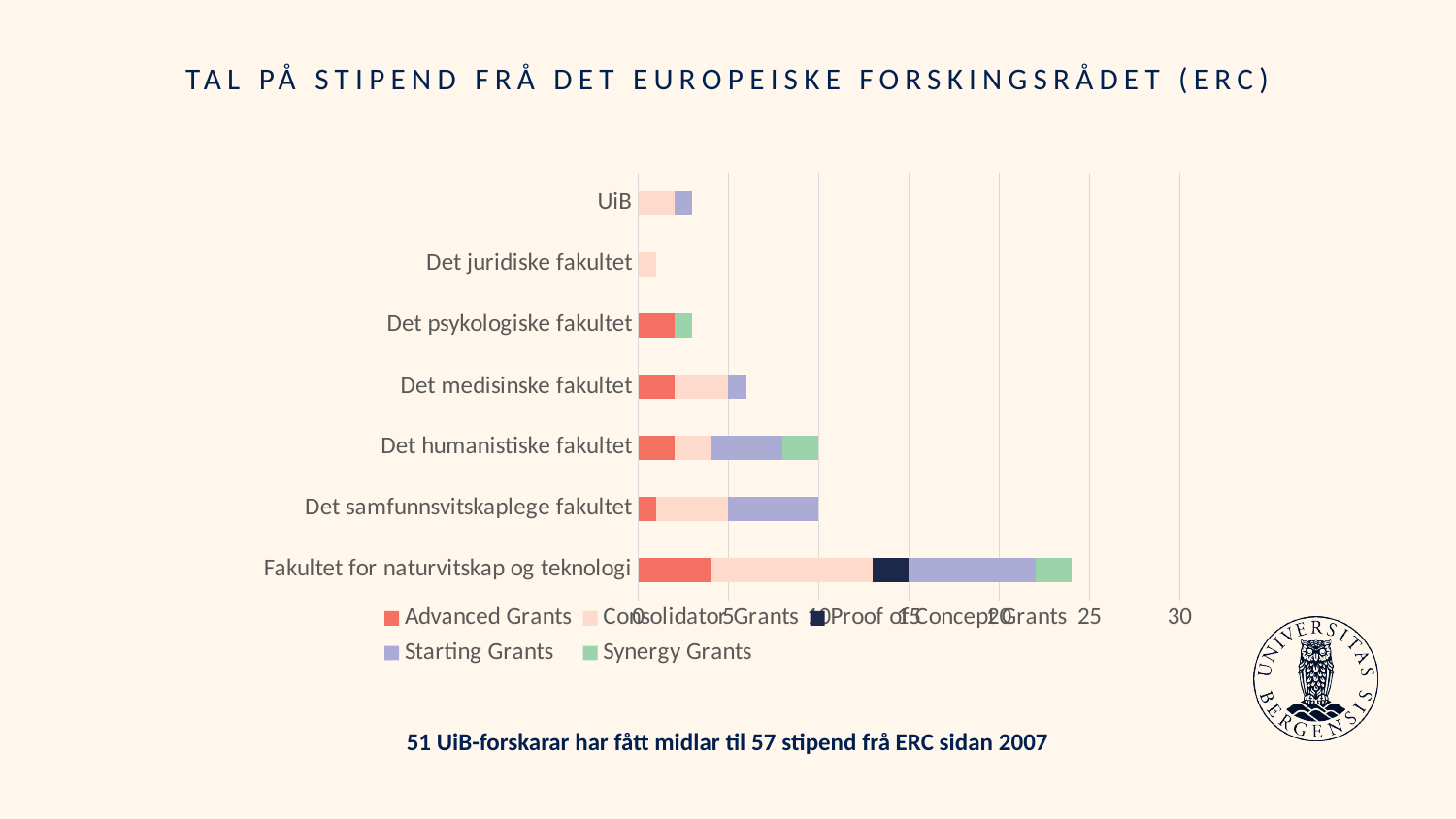
Is the total value for Det medisinske fakultet greater or less than 5? greater Is the total value for Fakultet for naturvitskap og teknologi greater or less than 20? greater Which has a larger total bar, Det medisinske fakultet or Det psykologiske fakultet? Det medisinske fakultet Which series is shown in dark navy in the legend? Proof of Concept Grants Is the total value for Det juridiske fakultet greater or less than 5? less How many faculties/categories are plotted on the chart? 7 Which category has the shortest total bar? Det juridiske fakultet What is the title of the chart? TAL PÅ STIPEND FRÅ DET EUROPEISKE FORSKINGSRÅDET (ERC) How many series does the legend list? 5 What kind of chart is shown on the slide? Stacked bar chart Which category has the longest total bar? Fakultet for naturvitskap og teknologi